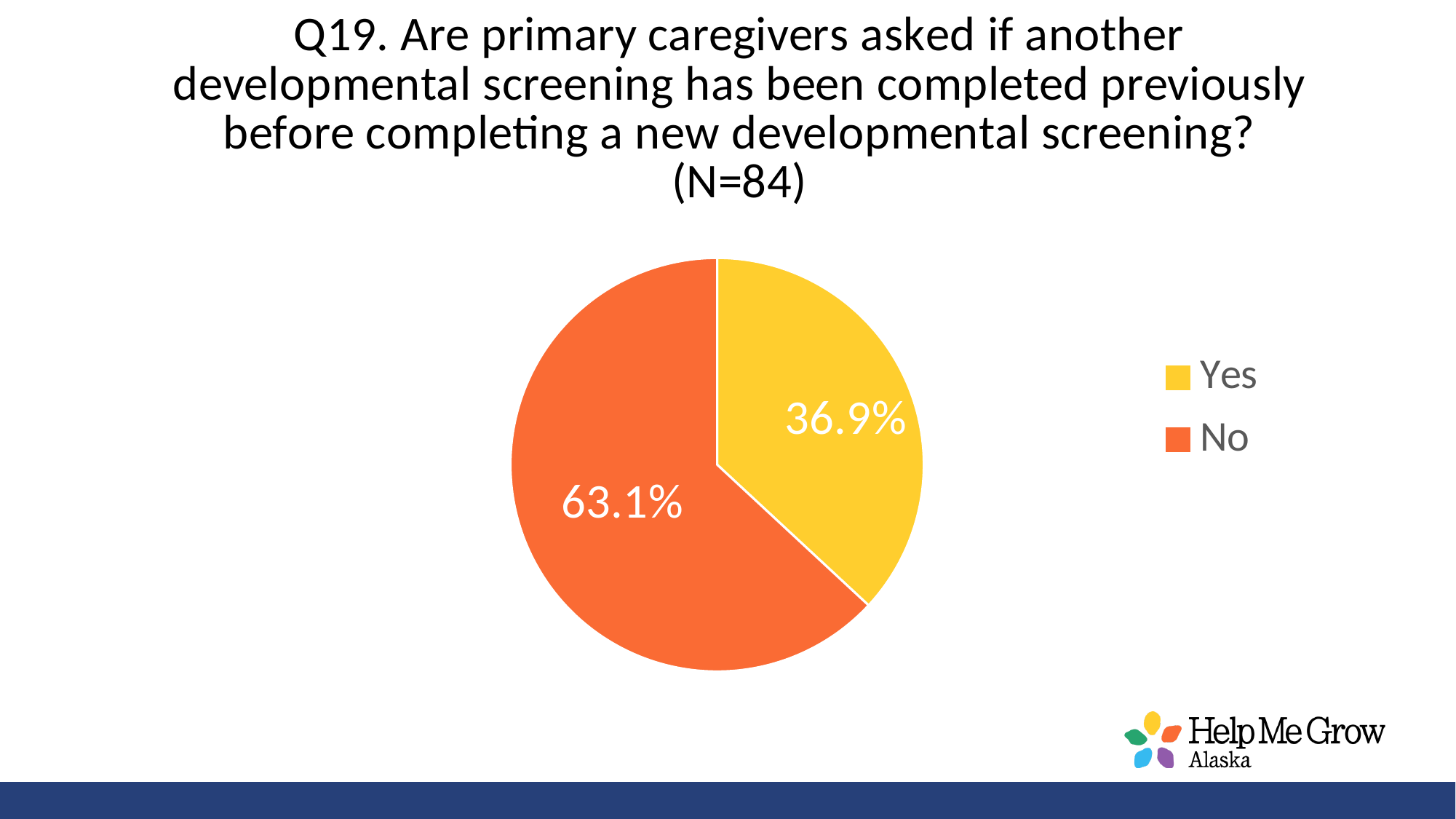
What is the sample size (N) stated in the chart title? 84 Which is larger, the Yes slice or the No slice? No Which response has the largest share of the pie? No What percentage of respondents answered Yes? 36.9% What is the difference in percentage points between the No and Yes slices? 26.2 Which response has the smallest share of the pie? Yes What kind of chart is shown on the slide? Pie chart How many entries does the legend list? 2 How many slices does the pie chart have? 2 What share of the pie does the Yes slice represent? 36.9% What colour is the No slice? Orange What percentage of respondents answered No? 63.1%